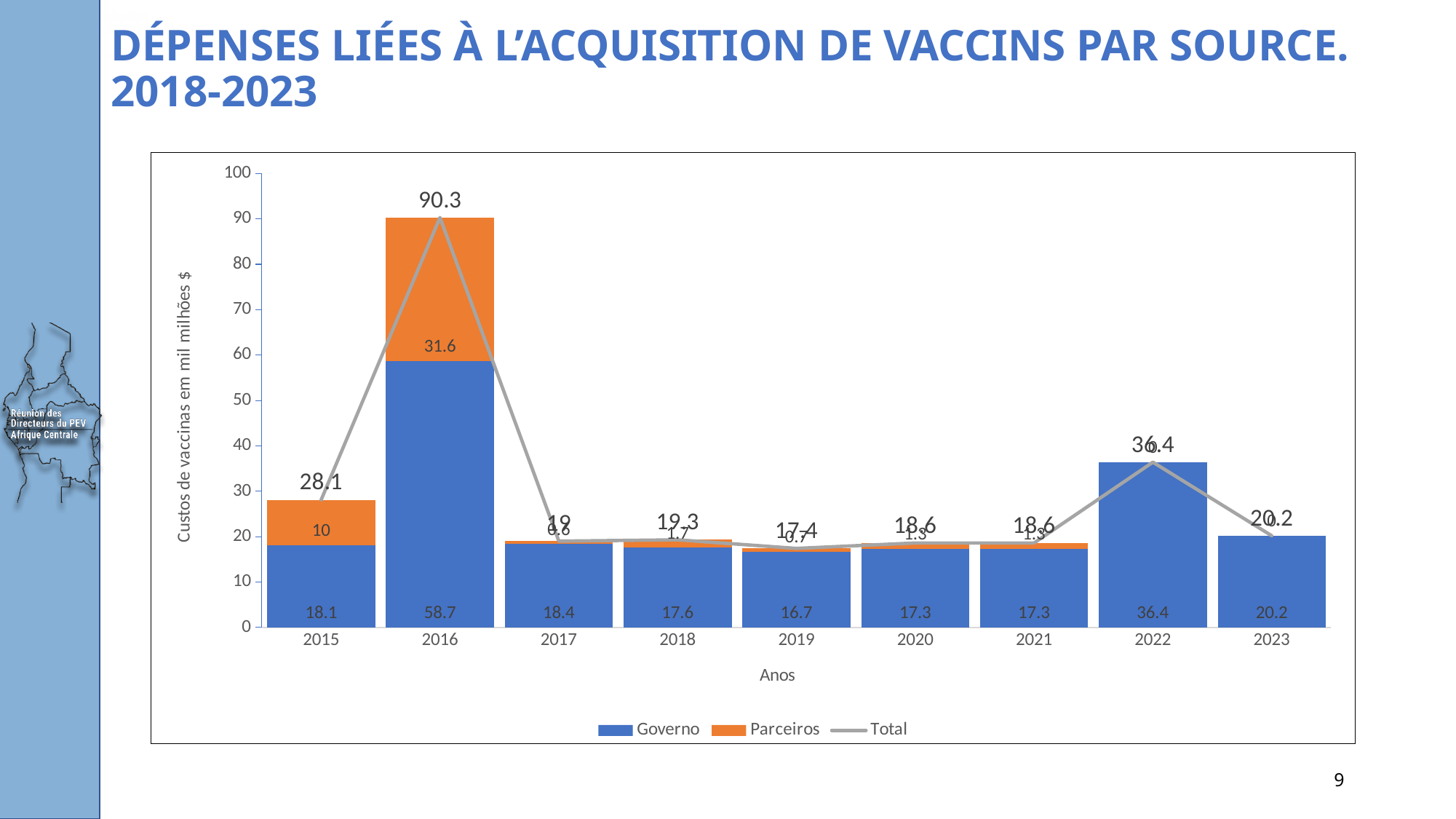
What kind of chart is shown on the slide? Stacked bar chart with a line Is the Total value for 2016 greater or less than 80? greater What is the difference between the Governo values for 2016 and 2015? 40.6 Which year has the larger Governo value, 2022 or 2023? 2022 What is the Parceiros value for 2015? 10 What is the Total value for 2022? 36.4 What is the Governo value for 2016? 58.7 Which year has the highest Total? 2016 How many years are shown on the x axis? 9 How many series does the legend list? 3 Which year has the lowest Governo value? 2019 What is the Parceiros value for 2016? 31.6